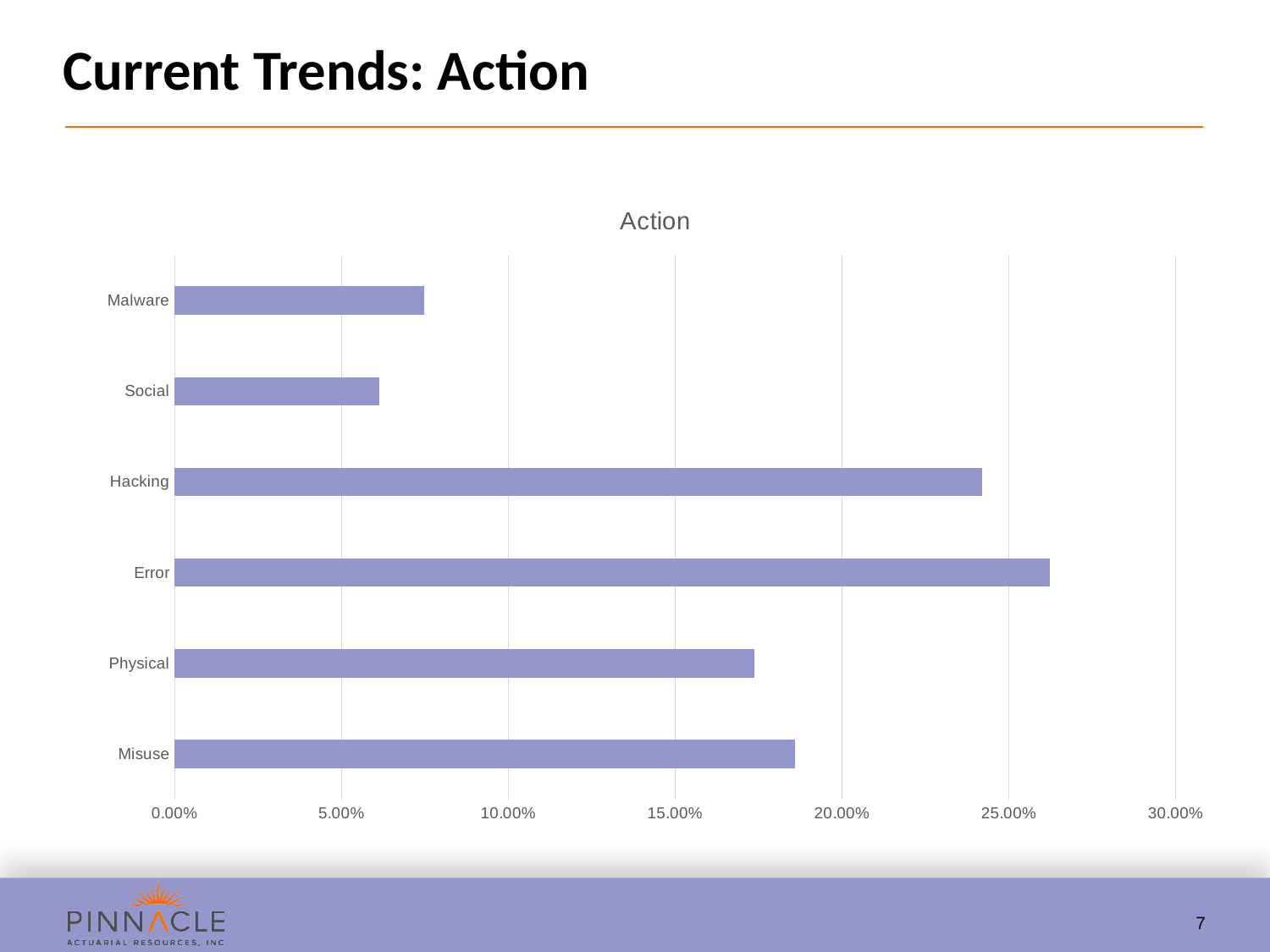
Which category has the lowest value? Social Is the value for Physical greater or less than 15.00%? greater What kind of chart is shown on the slide? bar chart Which is larger, the value for Malware or the value for Social? Malware Is the value for Malware greater or less than 10.00%? less Which is larger, the value for Misuse or the value for Malware? Misuse How many categories are plotted in the chart? 6 Is the value for Error greater or less than 25.00%? greater What is the title of the chart? Action Which is larger, the value for Hacking or the value for Physical? Hacking Which category has the highest value? Error